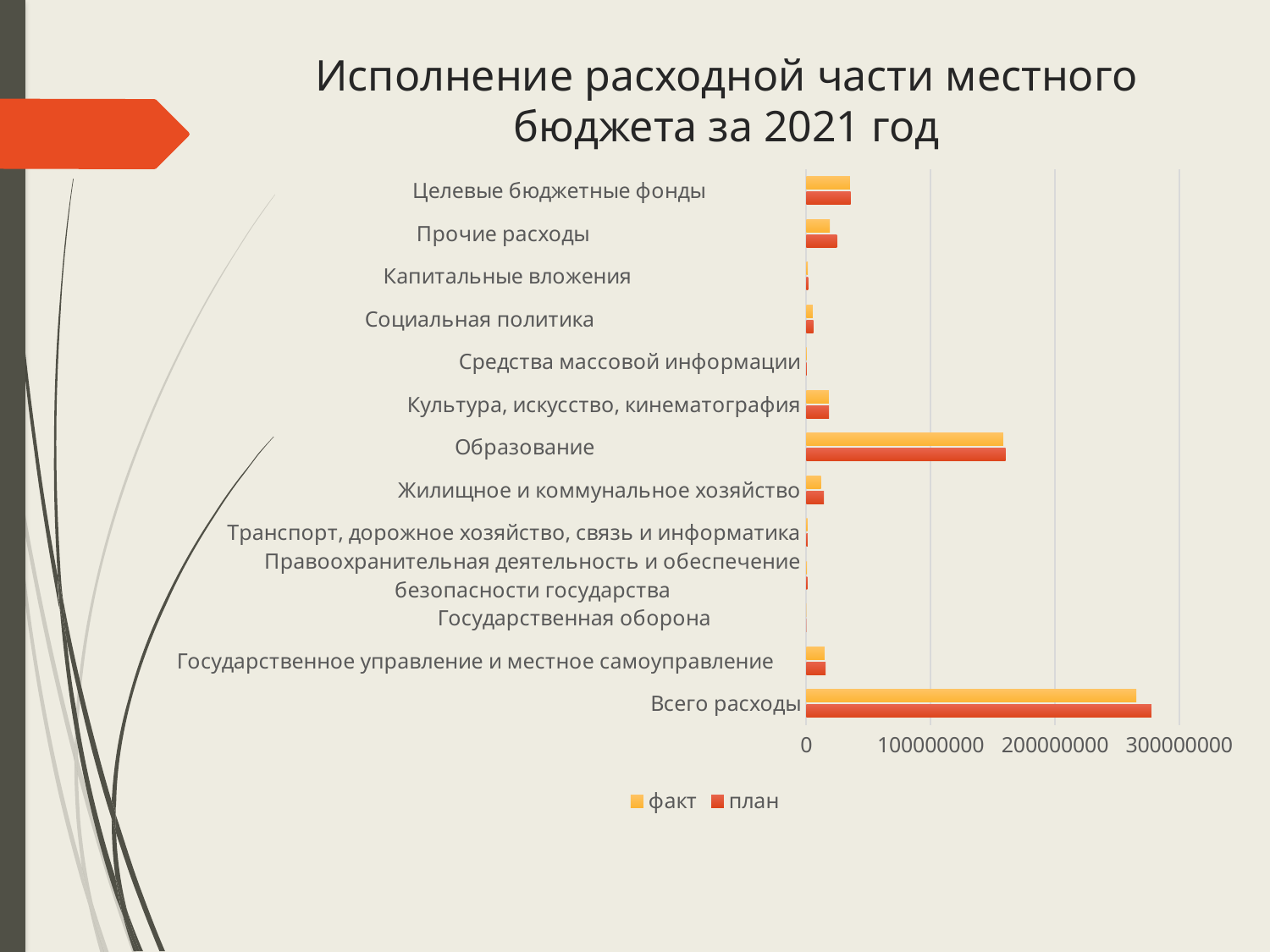
Is the факт value for Целевые бюджетные фонды greater or less than 100000000? less Which is larger for Всего расходы, the факт value or the план value? план How many categories are plotted on the chart? 13 What is the title of the chart on the slide? Исполнение расходной части местного бюджета за 2021 год How many series does the legend list? 2 What kind of chart is shown on the slide? bar chart Which category has the larger факт value, Образование or Культура, искусство, кинематография? Образование Is the план value for Всего расходы greater or less than 200000000? greater What are the two series named in the legend? факт and план Is the факт value for Образование greater or less than 100000000? greater Which category has the highest values on the chart? Всего расходы